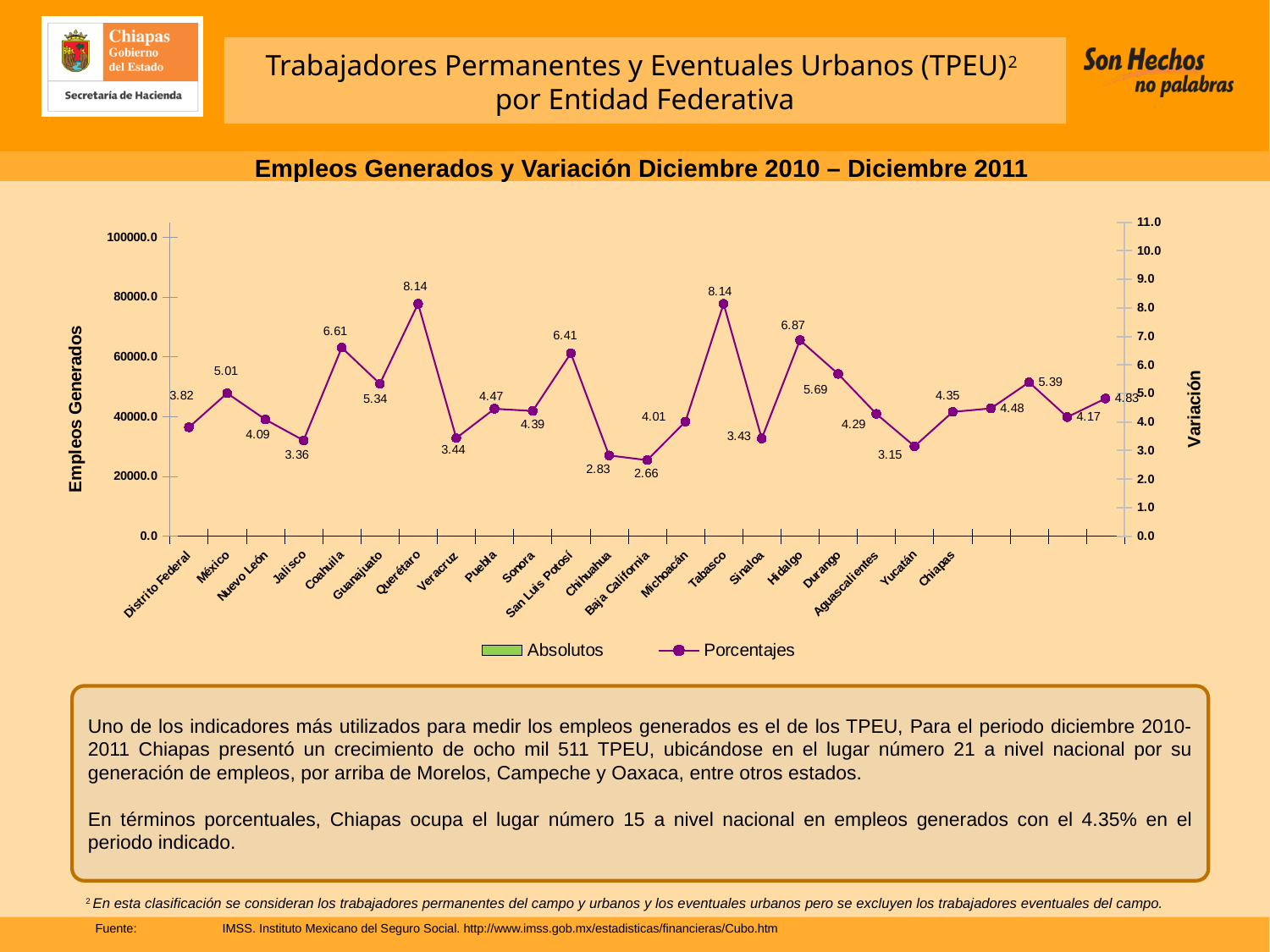
What is the title of the right-hand vertical axis? Variación What is the Porcentajes value for Baja California? 2.66 How many series does the legend list? 2 Is the Porcentajes value for Tabasco greater or less than 7.0? greater What is the Porcentajes value for Chiapas? 4.35 What is the difference between the Porcentajes values for Hidalgo and Chiapas? 2.52 Which entity has the lowest Porcentajes value? Baja California What are the two entries in the chart legend? Absolutos and Porcentajes What is the Porcentajes value for Querétaro? 8.14 What kind of chart is used to plot the Porcentajes series? Line chart Which has a higher Porcentajes value, Coahuila or Guanajuato? Coahuila What is the Porcentajes value for Hidalgo? 6.87